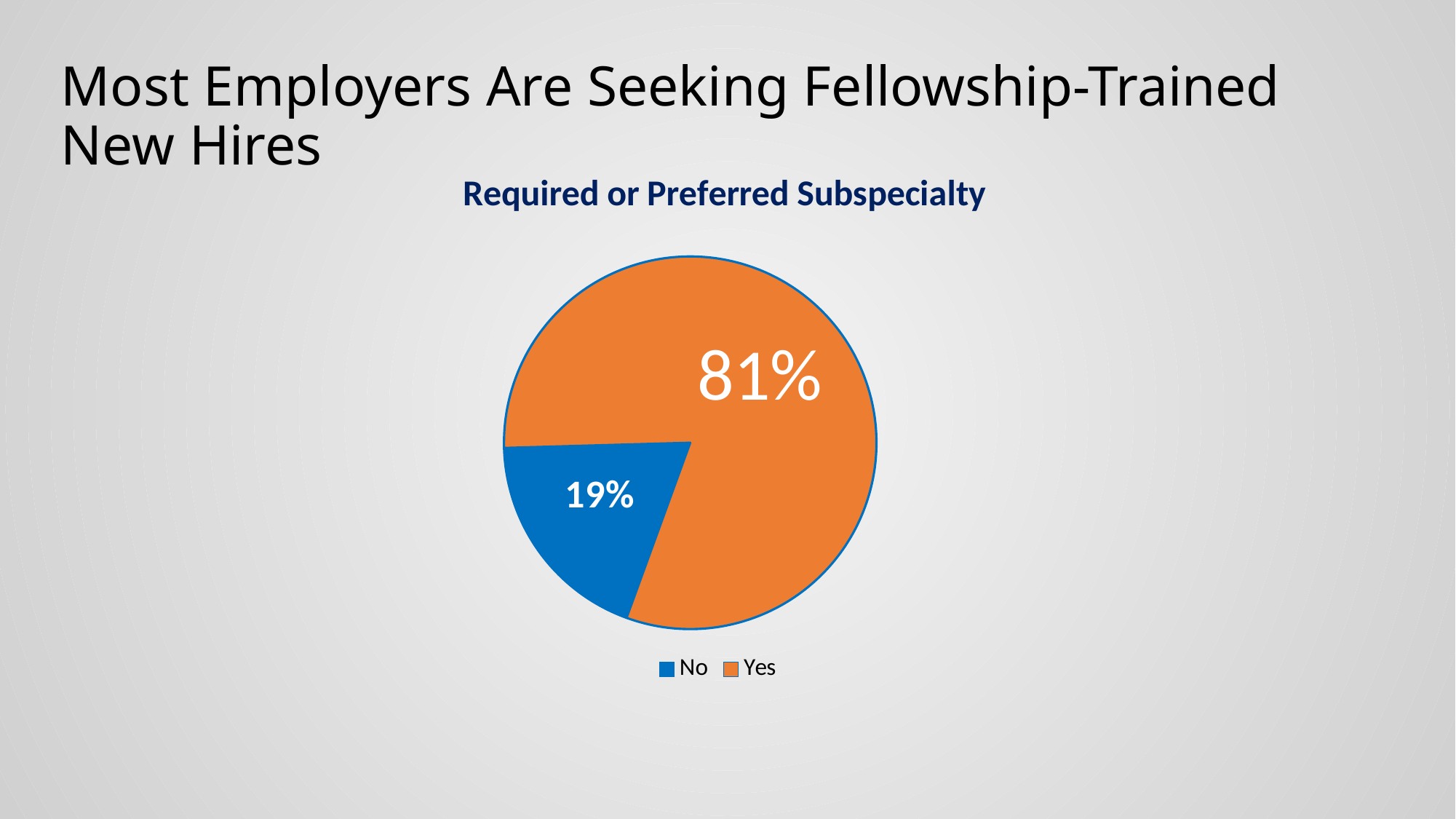
Which slice is the smallest? No What is the difference in percentage points between the "Yes" and "No" slices? 62 What is the chart's title? Required or Preferred Subspecialty What kind of chart is shown on the slide? Pie chart What share of the pie is labelled "Yes"? 81% Which is larger, the "Yes" slice or the "No" slice? Yes How many slices does the pie chart have? 2 Which slice is the largest? Yes What colour is the "No" slice? Blue What share of the pie is labelled "No"? 19% How many entries does the legend list? 2